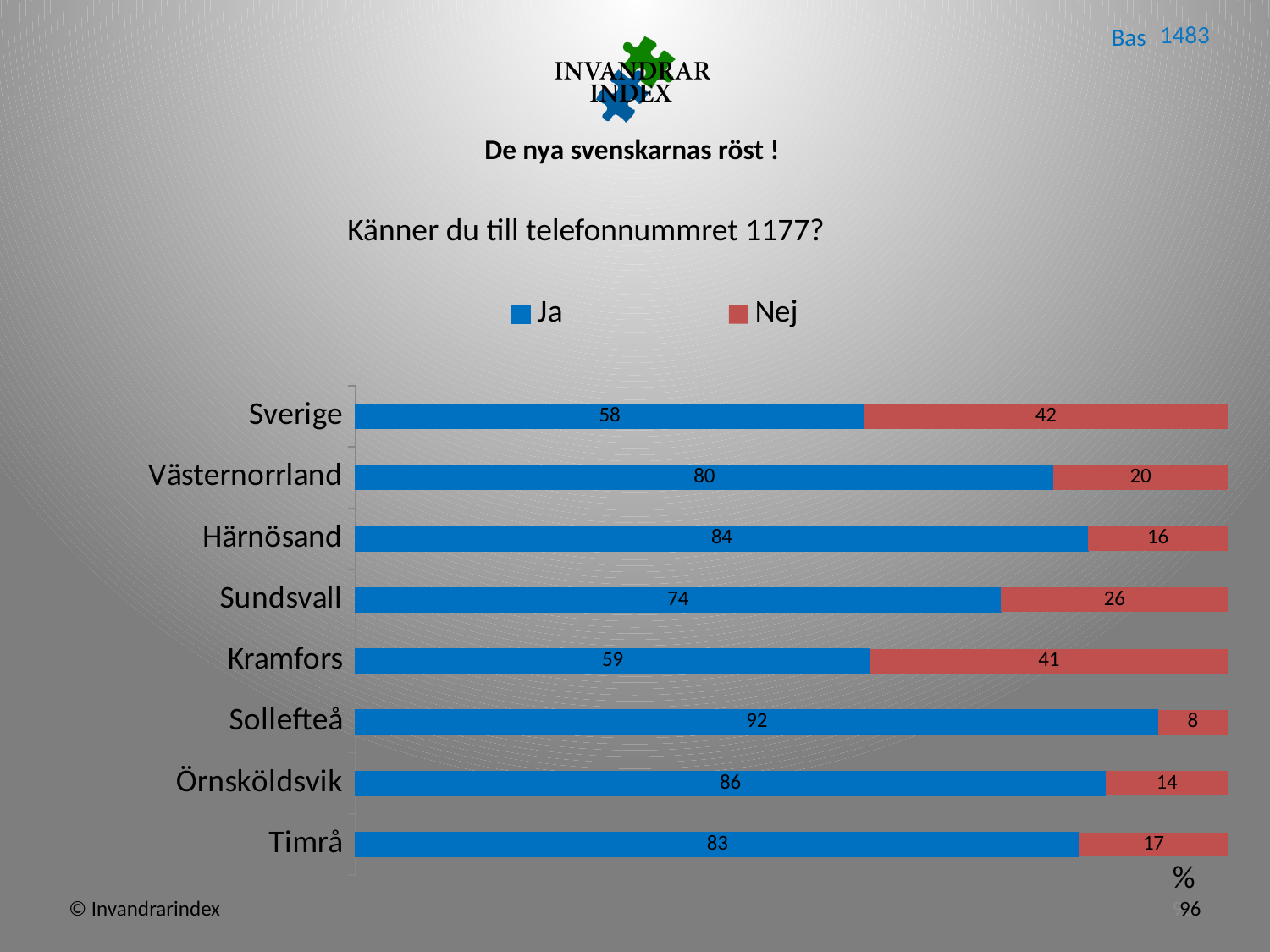
Which is larger, the 'Ja' value for Örnsköldsvik or for Timrå? Örnsköldsvik Which category has the highest 'Nej' value? Sverige What is the difference between the 'Ja' values for Härnösand and Kramfors? 25 What is the total of the stacked bar for Västernorrland? 100 How many categories are shown on the chart? 8 What kind of chart is shown on the slide? Stacked bar chart Which category has the highest 'Ja' value? Sollefteå What is the 'Nej' value for Sverige? 42 Which category has the lowest 'Ja' value? Sverige How many series does the legend list? 2 What is the 'Ja' value for Sundsvall? 74 What is the 'Ja' value for Sollefteå? 92